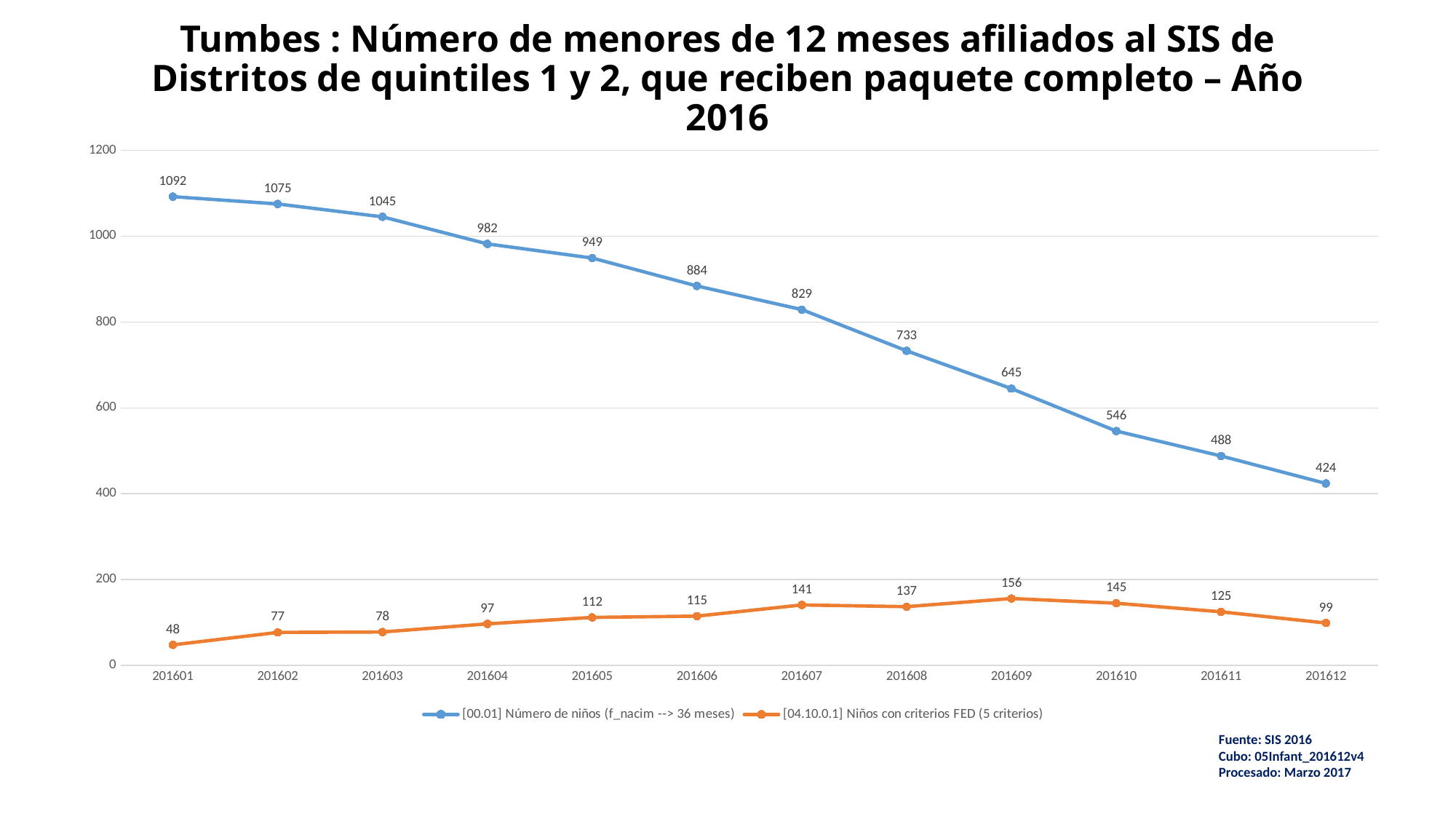
What is the difference between the '[00.01] Número de niños' value at 201601 and at 201612? 668 How many months are plotted on the x axis? 12 In which month does the '[04.10.0.1] Niños con criterios FED (5 criterios)' series have its lowest value? 201601 What is the difference between the two series at 201607? 688 In which month is the '[00.01] Número de niños (f_nacim --> 36 meses)' series lowest? 201612 What kind of chart is shown on the slide? Line chart What is the value of the '[00.01] Número de niños (f_nacim --> 36 meses)' series at 201601? 1092 How many series does the legend list? 2 Which is larger for the '[04.10.0.1] Niños con criterios FED (5 criterios)' series: the value at 201605 or at 201611? 201611 What is the value of the '[00.01] Número de niños (f_nacim --> 36 meses)' series at 201612? 424 In which month does the '[04.10.0.1] Niños con criterios FED (5 criterios)' series reach its highest value? 201609 What is the value of the '[04.10.0.1] Niños con criterios FED (5 criterios)' series at 201609? 156